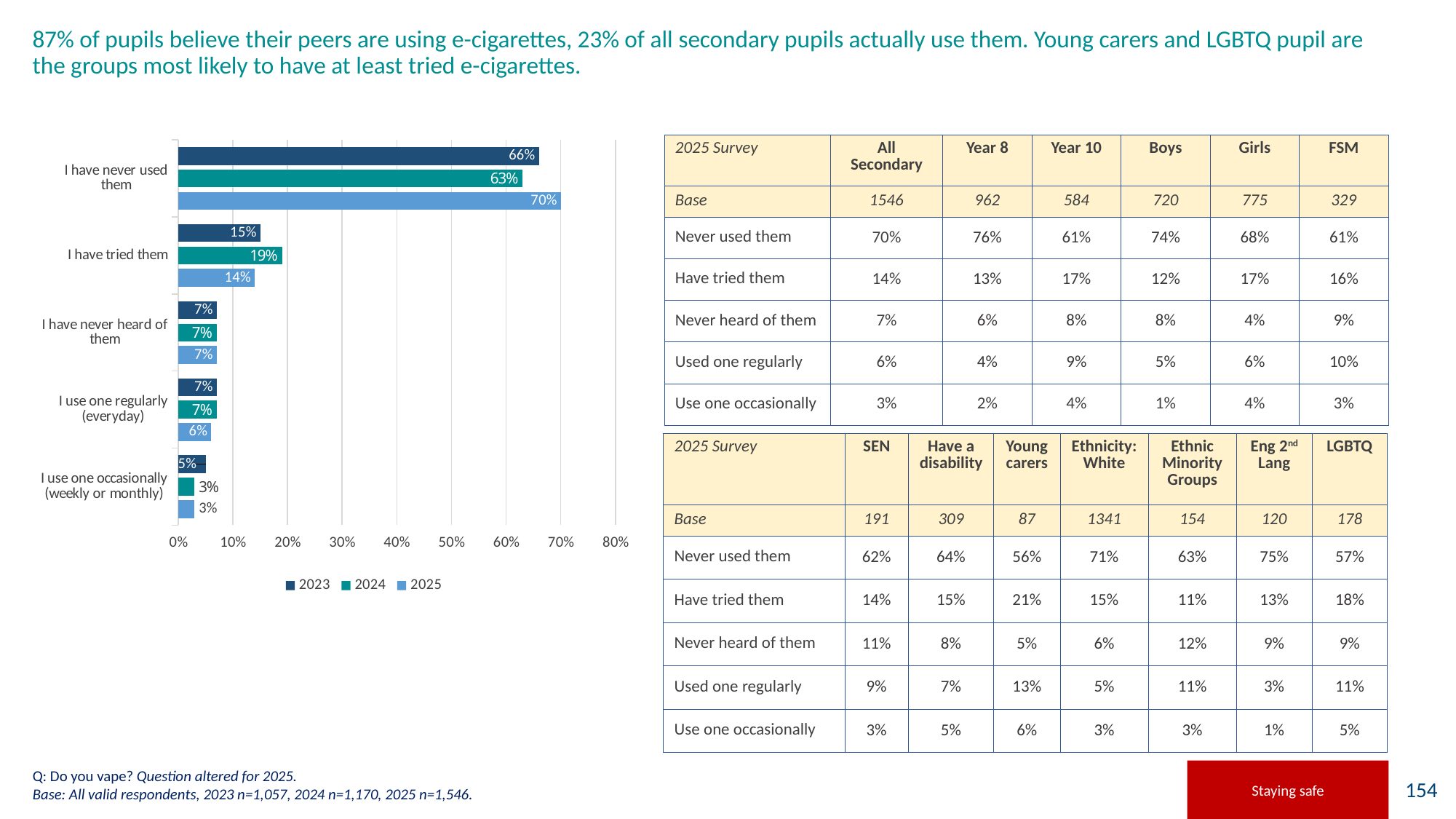
What is the difference between the 2025 and 2023 values for 'I have never used them'? 4% Which category has the lowest value for the 2025 series? I use one occasionally (weekly or monthly) What is the 2025 value for 'I have never used them'? 70% What kind of chart is shown on the slide? bar chart How many categories are shown on the chart? 5 Is the 2024 value for 'I have never used them' greater or less than 60%? greater What is the 2024 value for 'I have tried them'? 19% Which is larger for 'I have tried them': the 2024 value or the 2025 value? 2024 How many series does the chart's legend list? 3 What is the 2023 value for 'I use one occasionally (weekly or monthly)'? 5% Which series is shown in the lightest blue colour in the chart? 2025 Which category has the highest value for the 2023 series? I have never used them